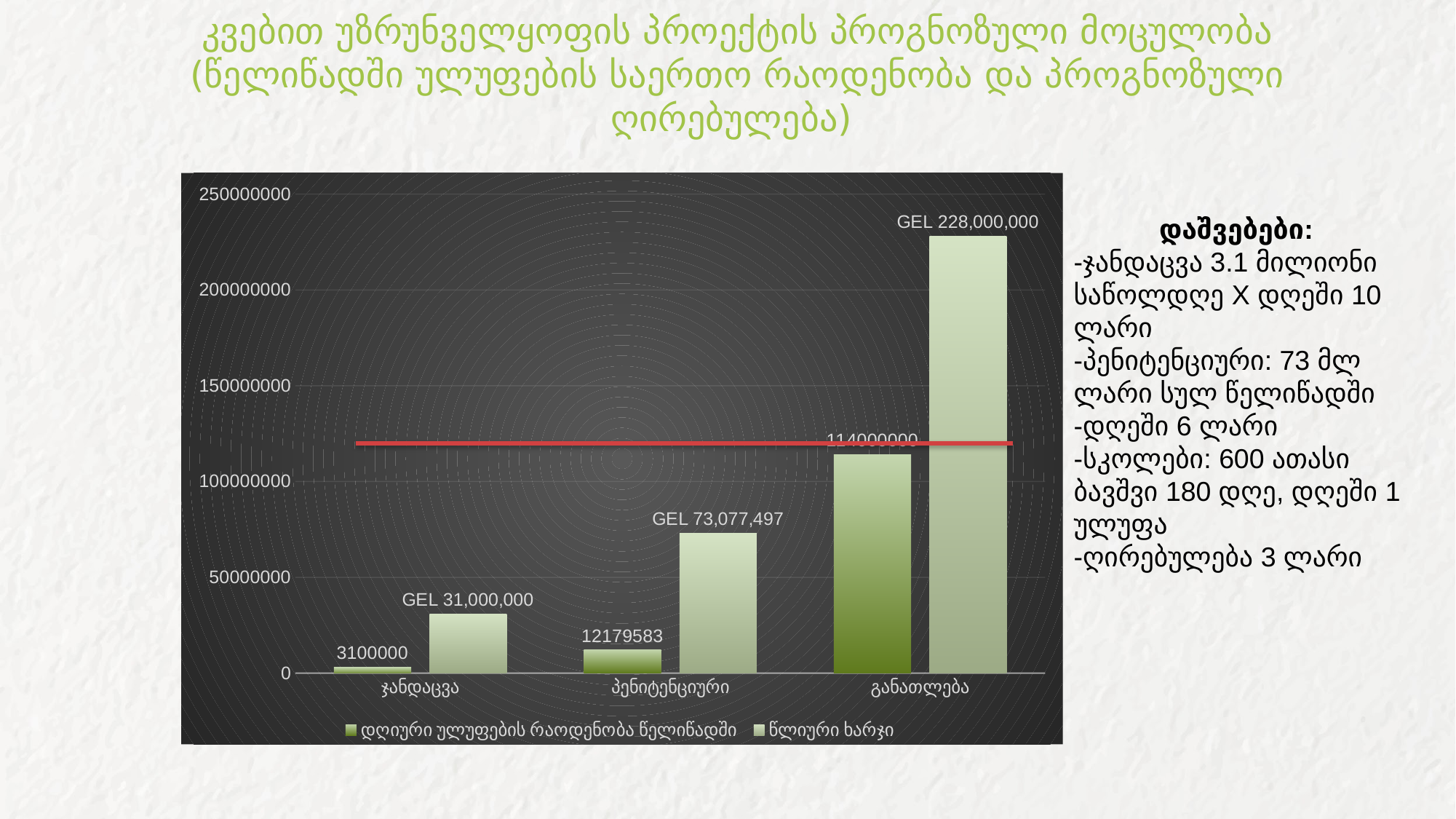
What is the value of დღიური ულუფების რაოდენობა წელიწადში for პენიტენციური? 12179583 How many series does the chart legend list? 2 What is the value of დღიური ულუფების რაოდენობა წელიწადში for ჯანდაცვა? 3100000 What is the value of წლიური ხარჯი for პენიტენციური? GEL 73,077,497 How many categories are shown on the x axis of the chart? 3 Which category has the lowest დღიური ულუფების რაოდენობა წელიწადში? ჯანდაცვა Which category has the highest წლიური ხარჯი? განათლება What is the value of წლიური ხარჯი for განათლება? GEL 228,000,000 Is the value of დღიური ულუფების რაოდენობა წელიწადში for განათლება greater or less than 100000000? greater What is the difference in წლიური ხარჯი between განათლება and პენიტენციური? GEL 154,922,503 What is the value of წლიური ხარჯი for ჯანდაცვა? GEL 31,000,000 What type of chart is shown on the slide? bar chart